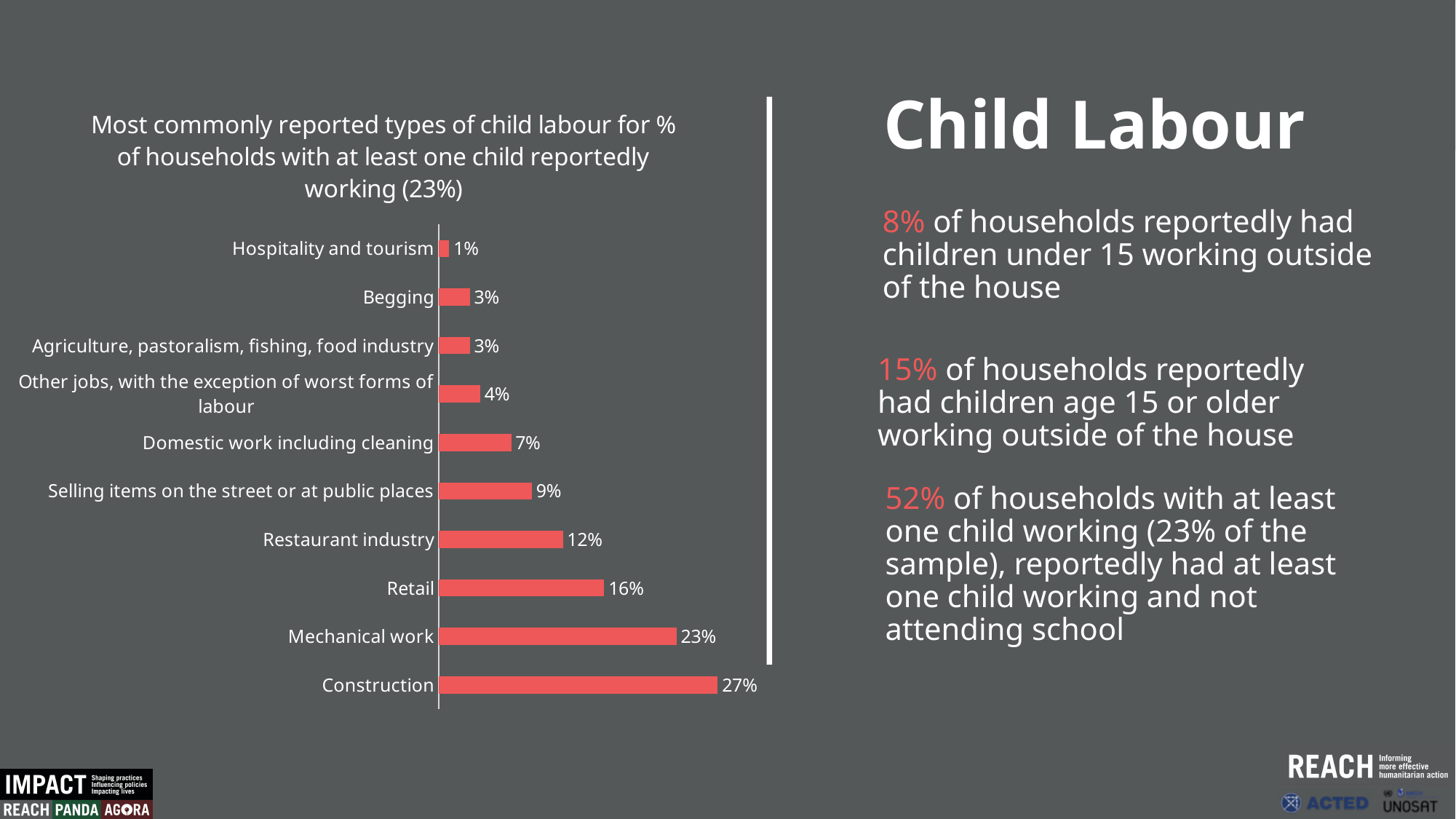
Do the values increase or decrease going from the top category to the bottom category? Increase What percentage is reported for Domestic work including cleaning? 7% What is the value for Retail? 16% Which type of child labour has the lowest reported percentage? Hospitality and tourism Which type of child labour has the highest reported percentage? Construction What kind of chart is shown on the slide? Bar chart What percentage is shown for Construction? 27% What is the difference between the values for Construction and Mechanical work? 4% Which is larger, the value for Selling items on the street or at public places or the value for Domestic work including cleaning? Selling items on the street or at public places What is the difference between the values for Retail and Restaurant industry? 4% What colour are the bars in the chart? Red How many types of child labour are shown in the chart? 10